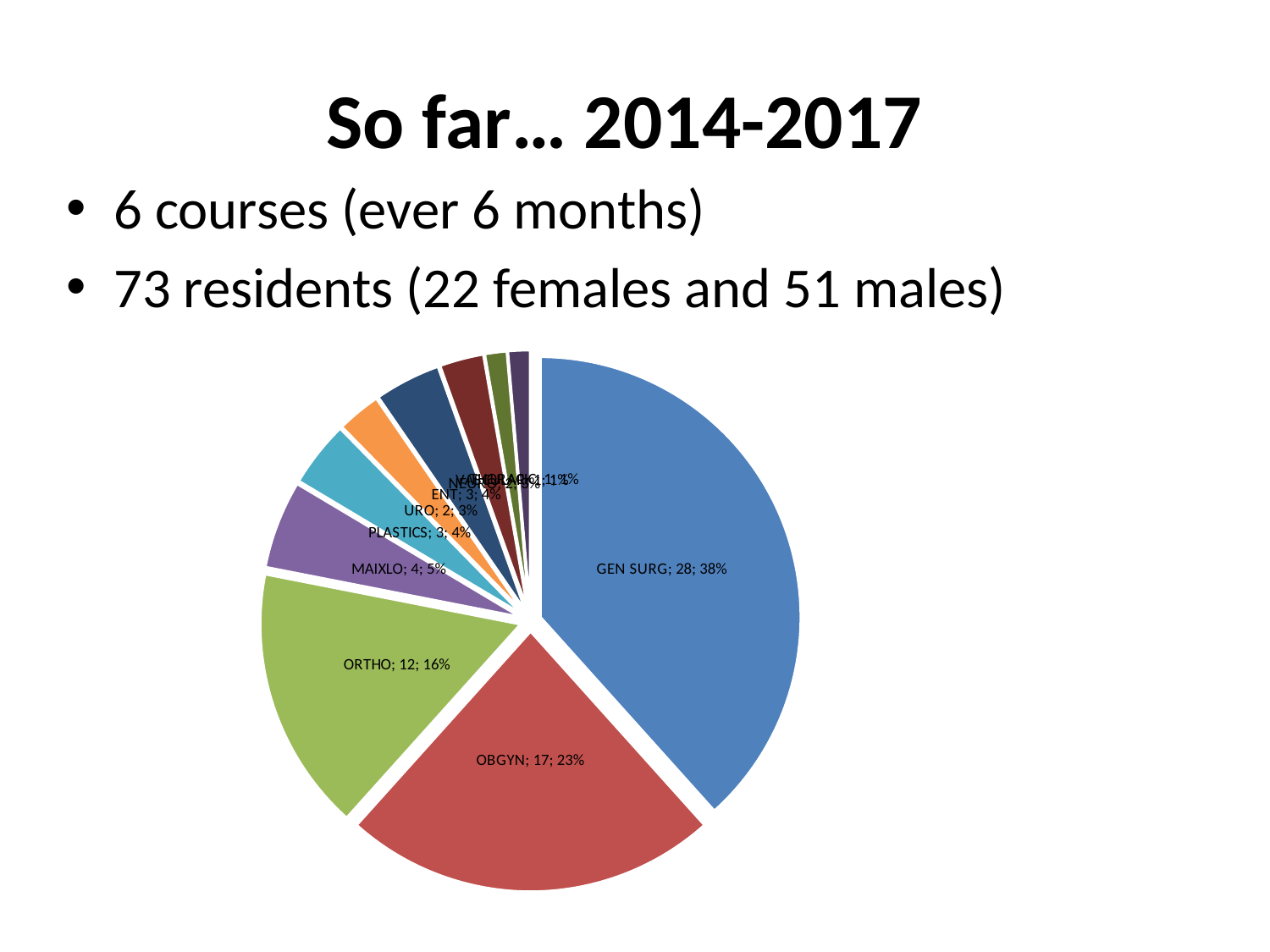
Which slice is larger, OBGYN or ORTHO? OBGYN Which specialty has the largest slice of the pie chart? GEN SURG How many residents are in the MAIXLO slice? 4 What colour is the GEN SURG slice of the pie chart? blue How many residents are in the GEN SURG slice of the pie chart? 28 What is the difference in residents between GEN SURG and OBGYN? 11 What percentage of the pie is ORTHO? 16% How many residents are in the OBGYN slice? 17 How many residents are in the URO slice? 2 What percentage of the pie is PLASTICS? 4% What share of the pie does GEN SURG represent? 38% What kind of chart is shown on the slide? pie chart